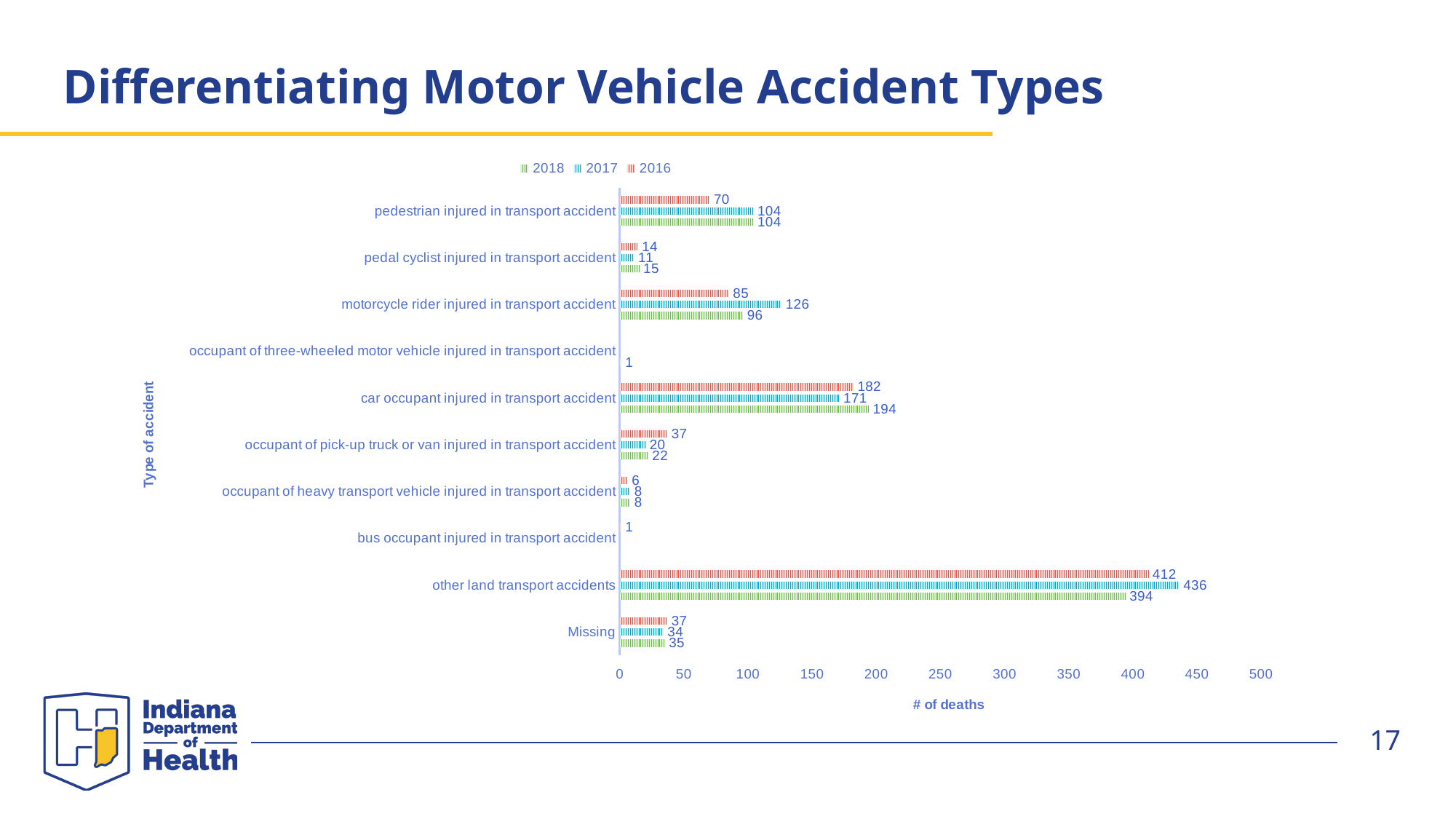
What is the number of deaths for Missing in 2017? 34 What is the difference between the 2017 and 2018 values for other land transport accidents? 42 What is the number of deaths for motorcycle rider injured in transport accident in 2017? 126 What is the label of the x axis? # of deaths Which is larger for pedal cyclist injured in transport accident: the 2016 value or the 2017 value? 2016 How many types of accident are listed on the y axis? 10 Which type of accident has the highest number of deaths in 2017? other land transport accidents What is the number of deaths for other land transport accidents in 2016? 412 What is the number of deaths for car occupant injured in transport accident in 2018? 194 What kind of chart is shown on the slide? bar chart Is the 2016 value for car occupant injured in transport accident greater or less than 150? greater How many series does the legend list? 3